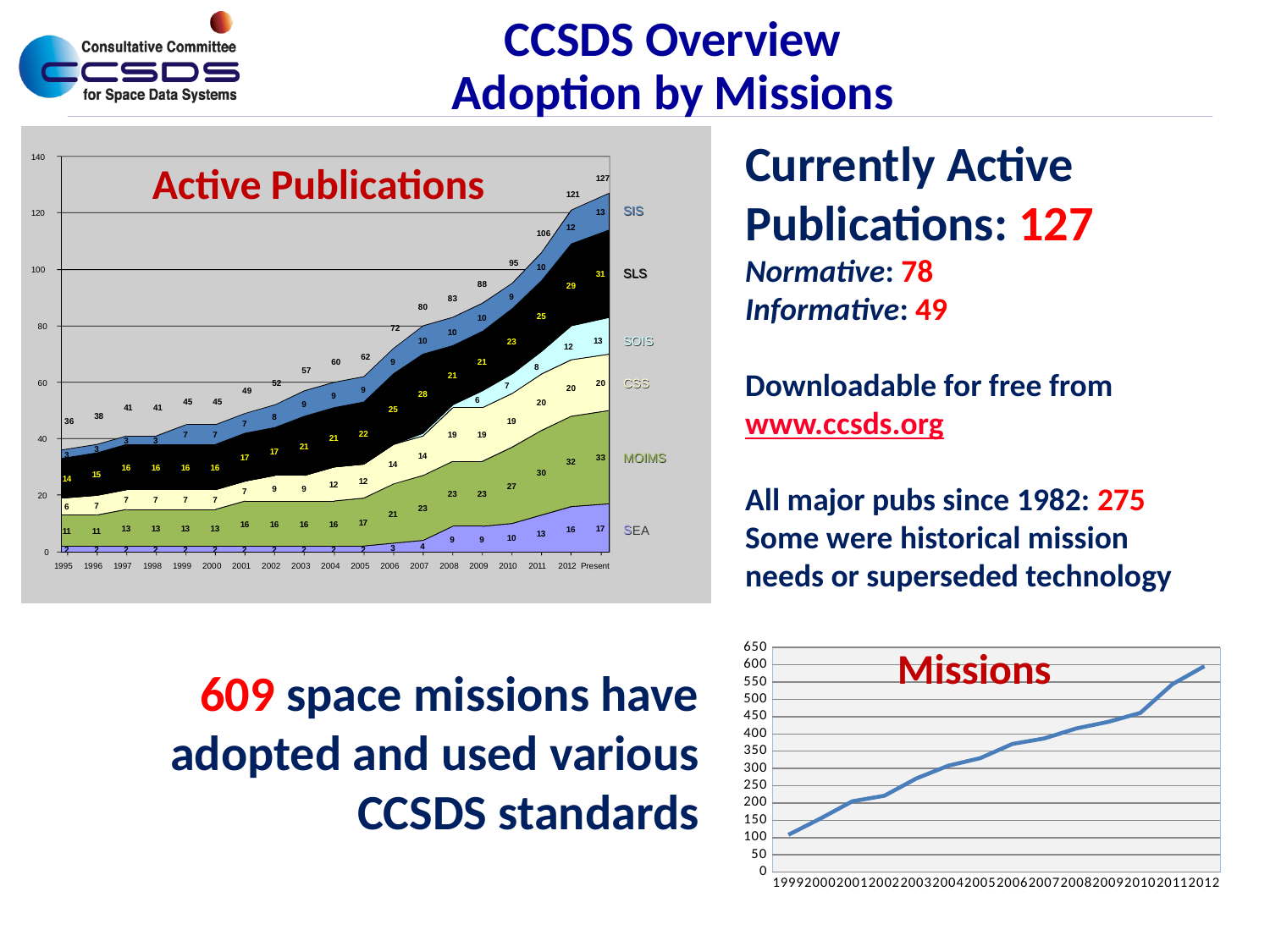
On the Active Publications chart, what is the total number of active publications shown for Present? 127 On the Active Publications chart, which year has the lowest total of active publications? 1995 On the Missions chart, is the value for 2012 greater or less than 550? greater On the Missions chart, do the values rise or fall from 1999 to 2012? Rise On the Active Publications chart, what is the SLS value shown for Present? 31 On the Active Publications chart, what is the difference between the totals for Present and 2012? 6 What kind of chart is the Missions chart? Line chart On the Missions chart, is the value for 1999 greater or less than 150? less On the Active Publications chart, what is the total number of active publications shown for 1995? 36 What kind of chart is the Active Publications chart? Stacked area chart On the Active Publications chart, how many series are labelled on the right side of the chart? 6 On the Active Publications chart, what is the MOIMS value shown for Present? 33